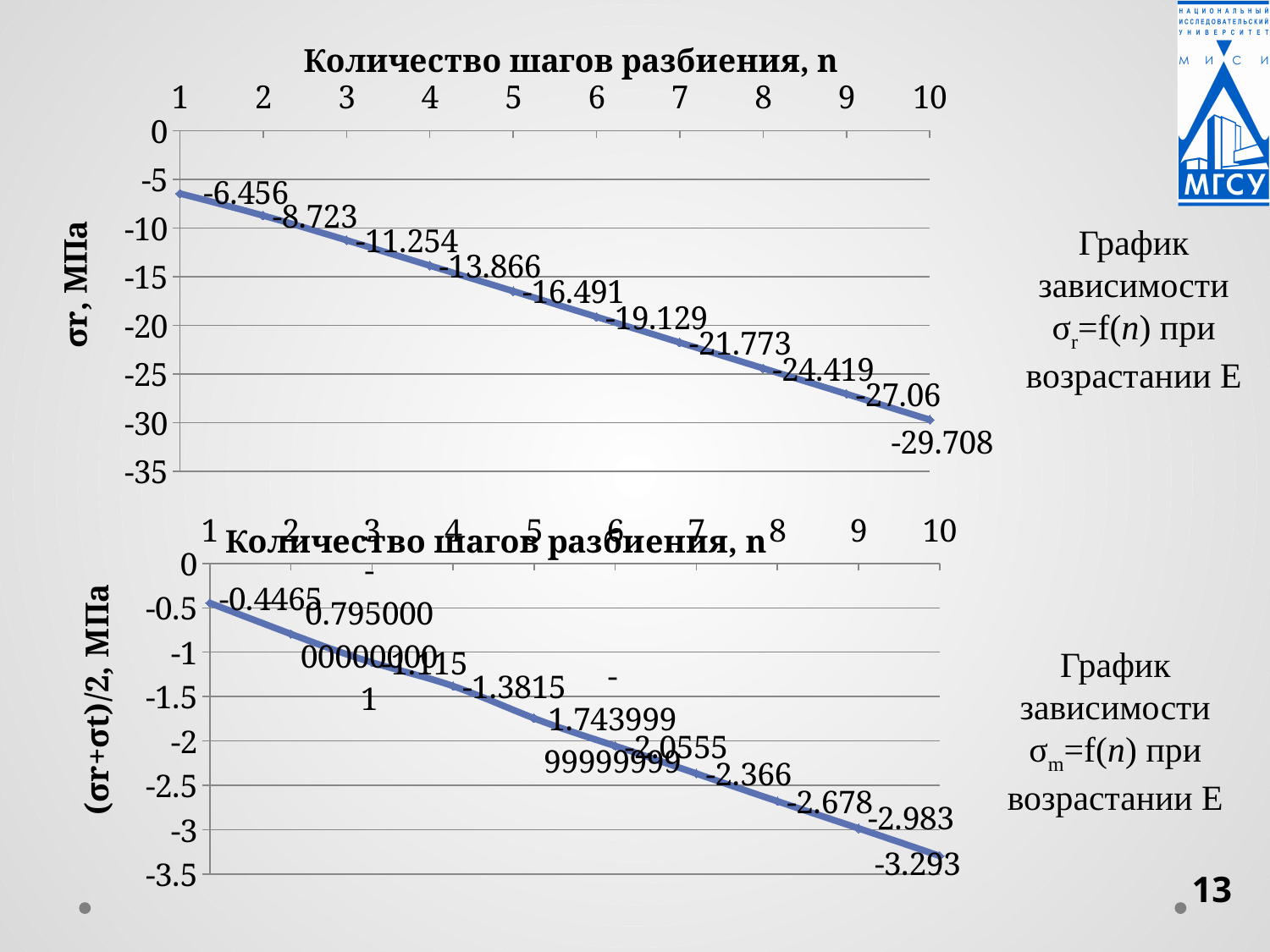
In the top chart (σr, МПа), how many data points are plotted? 10 In the top chart (σr, МПа), what is the difference between the values at n = 2 and n = 1? 2.267 In the top chart (σr, МПа), what is the value at n = 1? -6.456 In the bottom chart ((σr+σt)/2, МПа), which is larger, the value at n = 7 or at n = 9? n = 7 In the top chart (σr, МПа), at which n is the value highest? 1 In the top chart (σr, МПа), at which n is the value lowest? 10 In the bottom chart ((σr+σt)/2, МПа), what is the value at n = 10? -3.293 In the top chart (σr, МПа), what is the value at n = 5? -16.491 In the top chart (σr, МПа), do the values rise or fall as n increases? fall In the top chart (σr, МПа), what is the value at n = 10? -29.708 What type of chart is the bottom chart ((σr+σt)/2, МПа)? line chart In the bottom chart ((σr+σt)/2, МПа), what is the value at n = 1? -0.4465